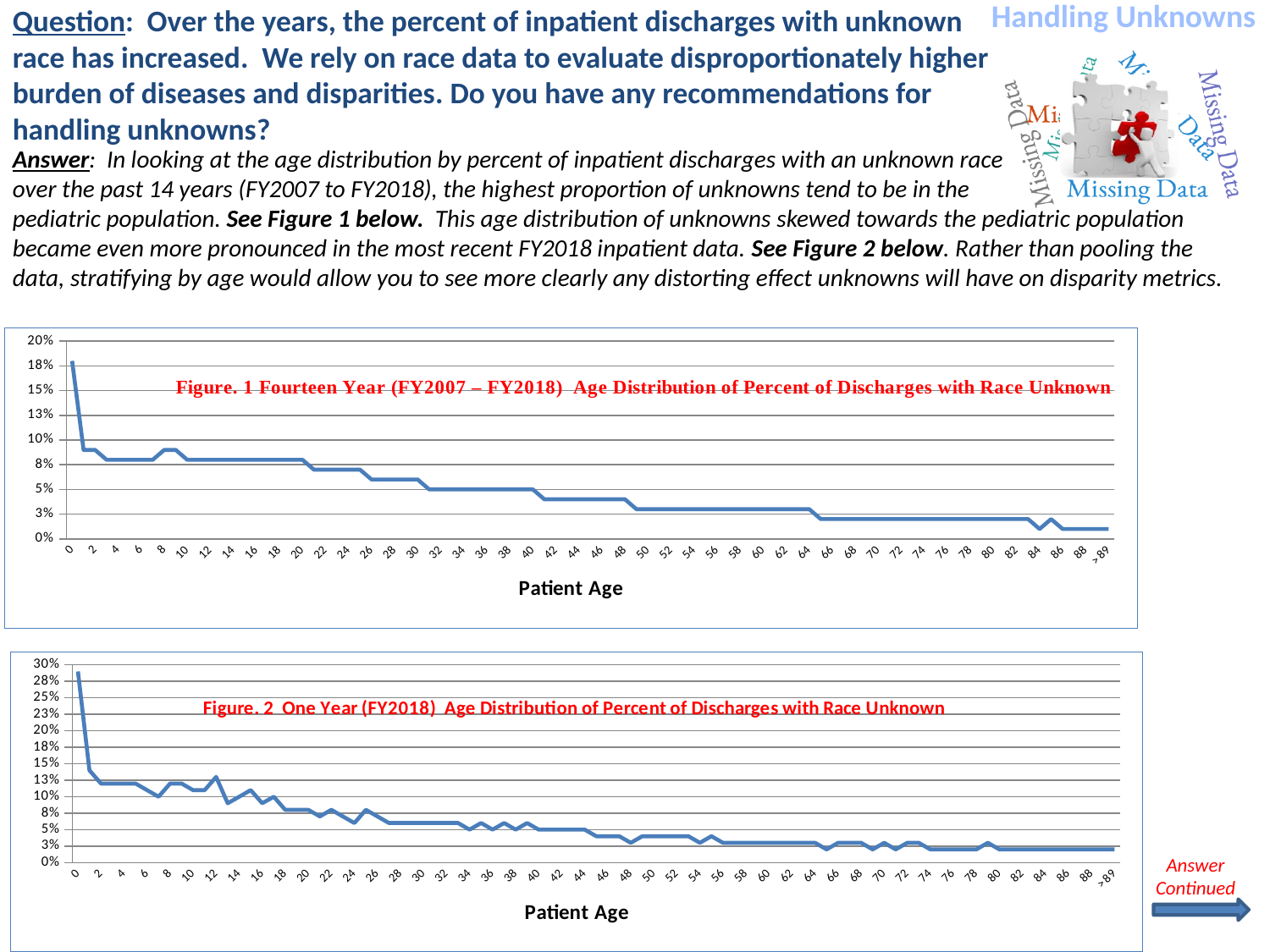
In Figure 1, is the value for patient age 0 greater or less than 15%? greater What kind of chart is Figure 2? line chart In Figure 2, is the value for patient age 0 greater or less than 25%? greater In Figure 1, is the value for patient age 80 greater or less than 3%? less In Figure 1, do the values generally rise or fall as patient age increases? fall What kind of chart is Figure 1? line chart What is the x-axis title of Figure 2? Patient Age In Figure 1, which patient age has the highest percent of discharges with race unknown? 0 In Figure 2, which patient age has the highest percent of discharges with race unknown? 0 In Figure 2, do the values generally rise or fall as patient age increases? fall